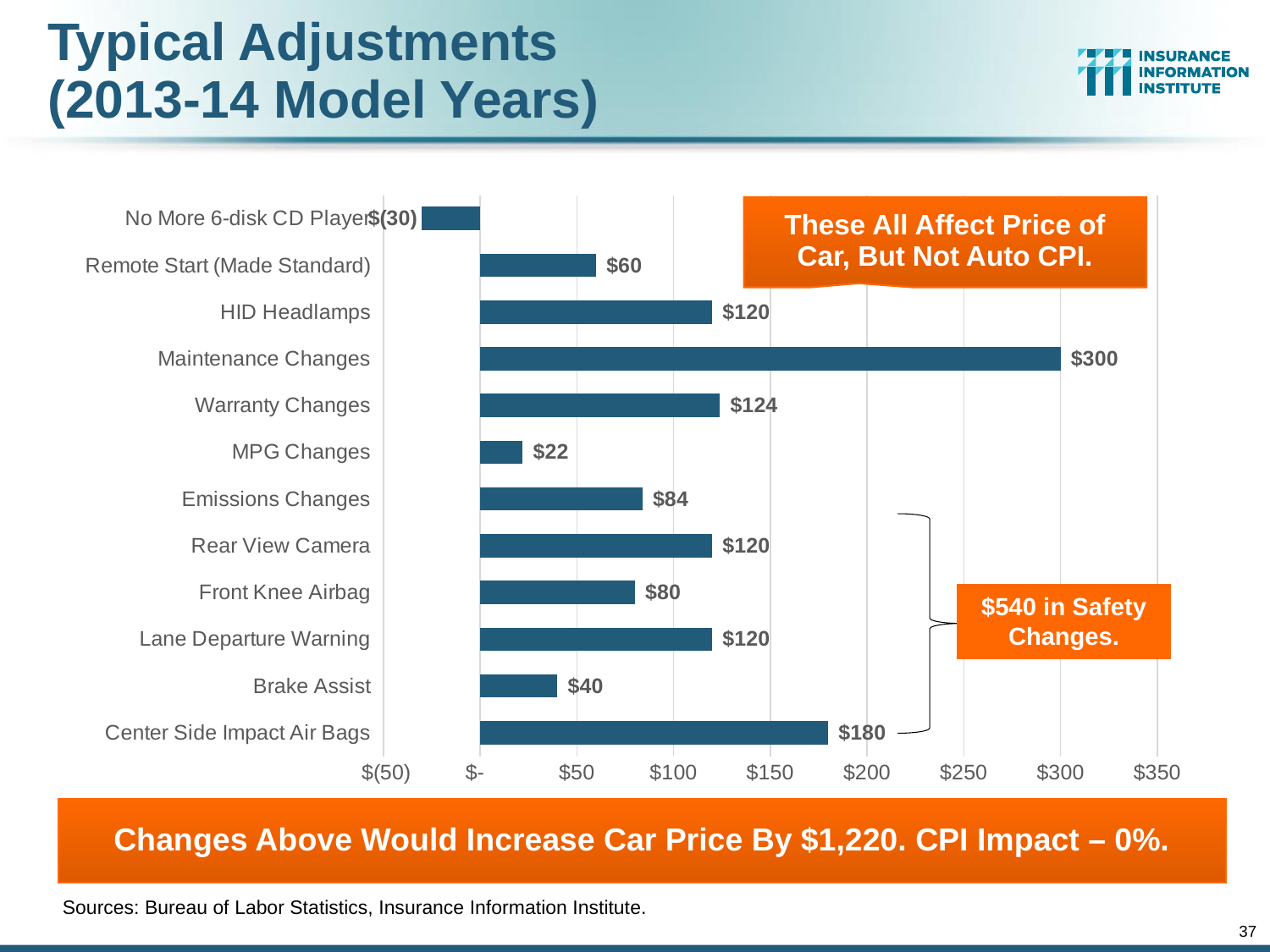
What is the value for Center Side Impact Air Bags? $180 According to the callout on the chart, how much do the safety changes total? $540 What is the value for MPG Changes? $22 Which is larger, Emissions Changes or Remote Start (Made Standard)? Emissions Changes Which category has the highest value? Maintenance Changes What is the value for Maintenance Changes? $300 What is the value for No More 6-disk CD Player? $(30) What kind of chart is shown on the slide? Bar chart Which category has the lowest value? No More 6-disk CD Player What is the difference between Rear View Camera and Brake Assist? $80 How many categories are shown in the chart? 12 What is the difference between Maintenance Changes and Center Side Impact Air Bags? $120